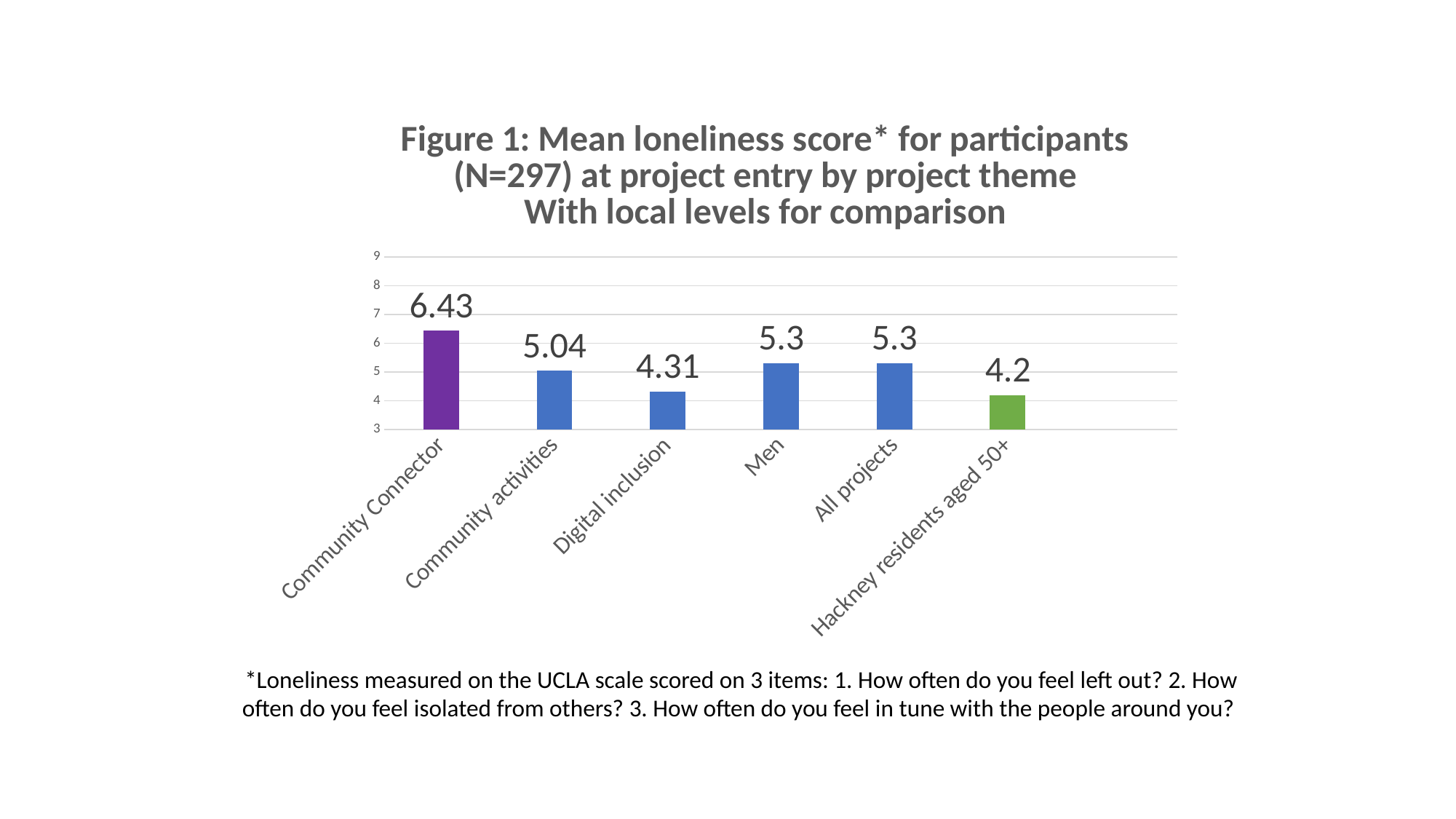
What is the mean loneliness score for Hackney residents aged 50+? 4.2 What is the difference between the scores for Community Connector and Community activities? 1.39 Which has a higher mean loneliness score, Men or Digital inclusion? Men What colour is the bar for Hackney residents aged 50+? Green Is the value for Community activities greater or less than 5? greater Which category has the lowest mean loneliness score? Hackney residents aged 50+ Which category has the highest mean loneliness score? Community Connector What is the mean loneliness score for Digital inclusion? 4.31 How many categories are shown on the x axis? 6 What is the mean loneliness score for All projects? 5.3 What kind of chart is shown on the slide? Bar chart What is the mean loneliness score for Community Connector? 6.43